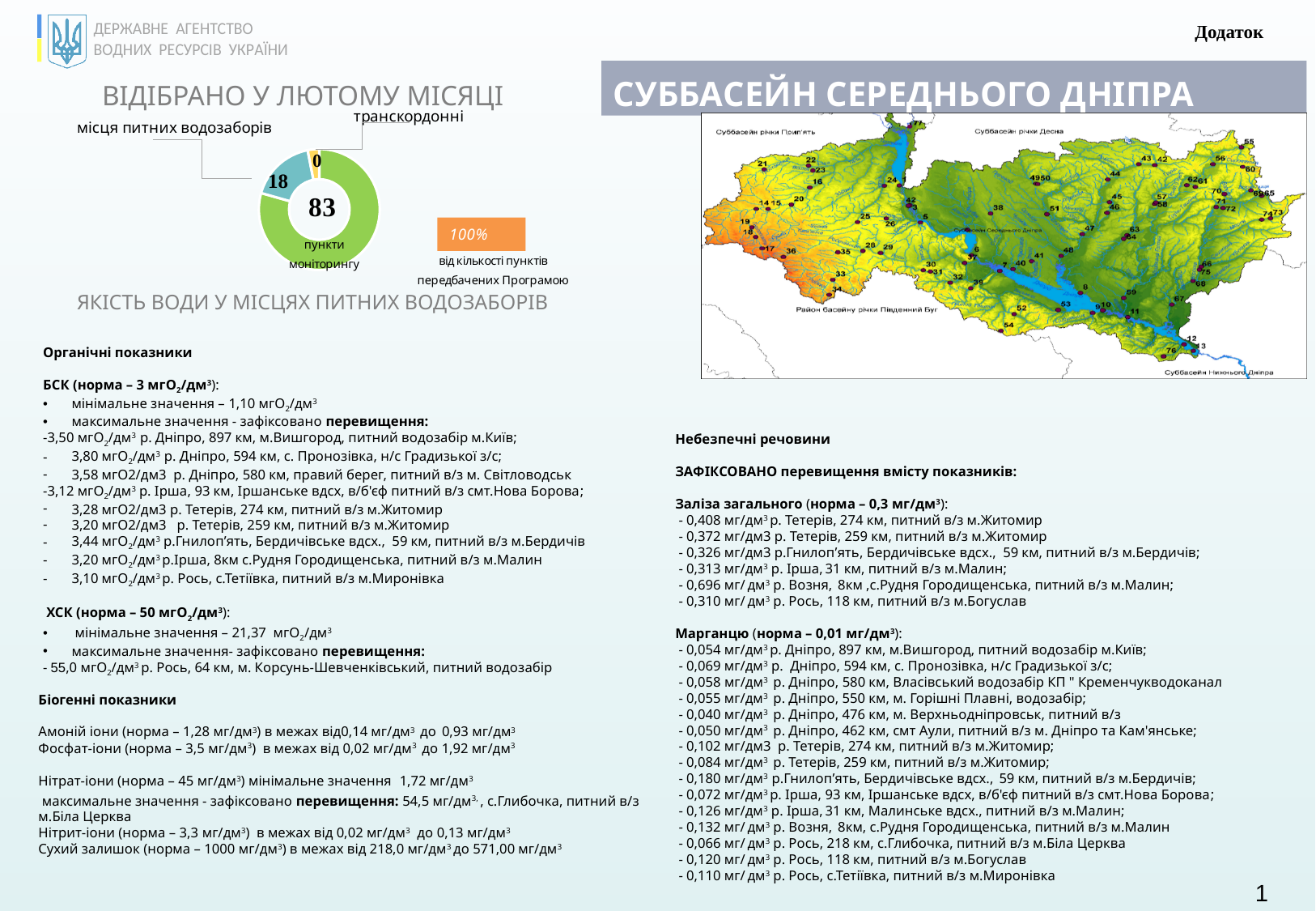
What kind of chart is shown under the title "ВІДІБРАНО У ЛЮТОМУ МІСЯЦІ"? pie chart (donut) In the donut chart, what value is shown for "транскордонні"? 0 What colour is the "місця питних водозаборів" segment in the donut chart? blue In the donut chart, which is larger: "місця питних водозаборів" or "транскордонні"? місця питних водозаборів What is the difference between the values for "місця питних водозаборів" and "транскордонні" in the donut chart? 18 In the donut chart, which labelled category has the lowest value? транскордонні How many coloured segments does the donut chart have? 3 In the donut chart, what value is shown for "місця питних водозаборів"? 18 What is the title above the donut chart? ВІДІБРАНО У ЛЮТОМУ МІСЯЦІ What number is printed in the centre of the donut chart for "пункти моніторингу"? 83